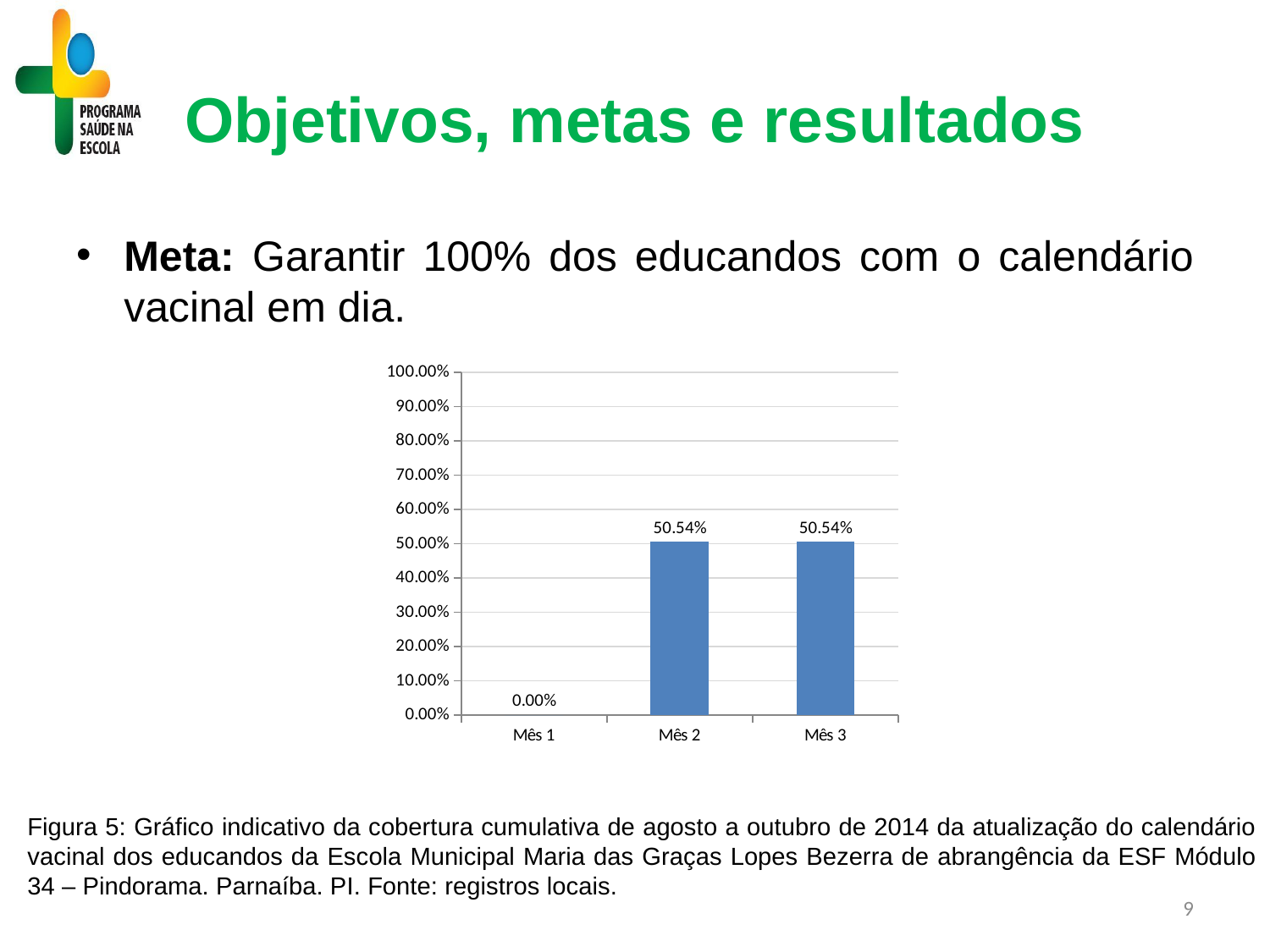
What kind of chart is shown on the slide? bar chart How many categories are shown on the x axis? 3 What is the difference between the values for Mês 2 and Mês 1? 50.54% Do the values rise or fall from Mês 1 to Mês 2? rise What is the difference between the values for Mês 3 and Mês 2? 0.00% What is the value for Mês 1? 0.00% What is the value for Mês 3? 50.54% What is the value for Mês 2? 50.54% Is the value for Mês 3 greater or less than 60.00%? less What is the highest value shown on the y axis? 100.00% Which category has the lowest value? Mês 1 Which is larger, the value for Mês 2 or the value for Mês 1? Mês 2